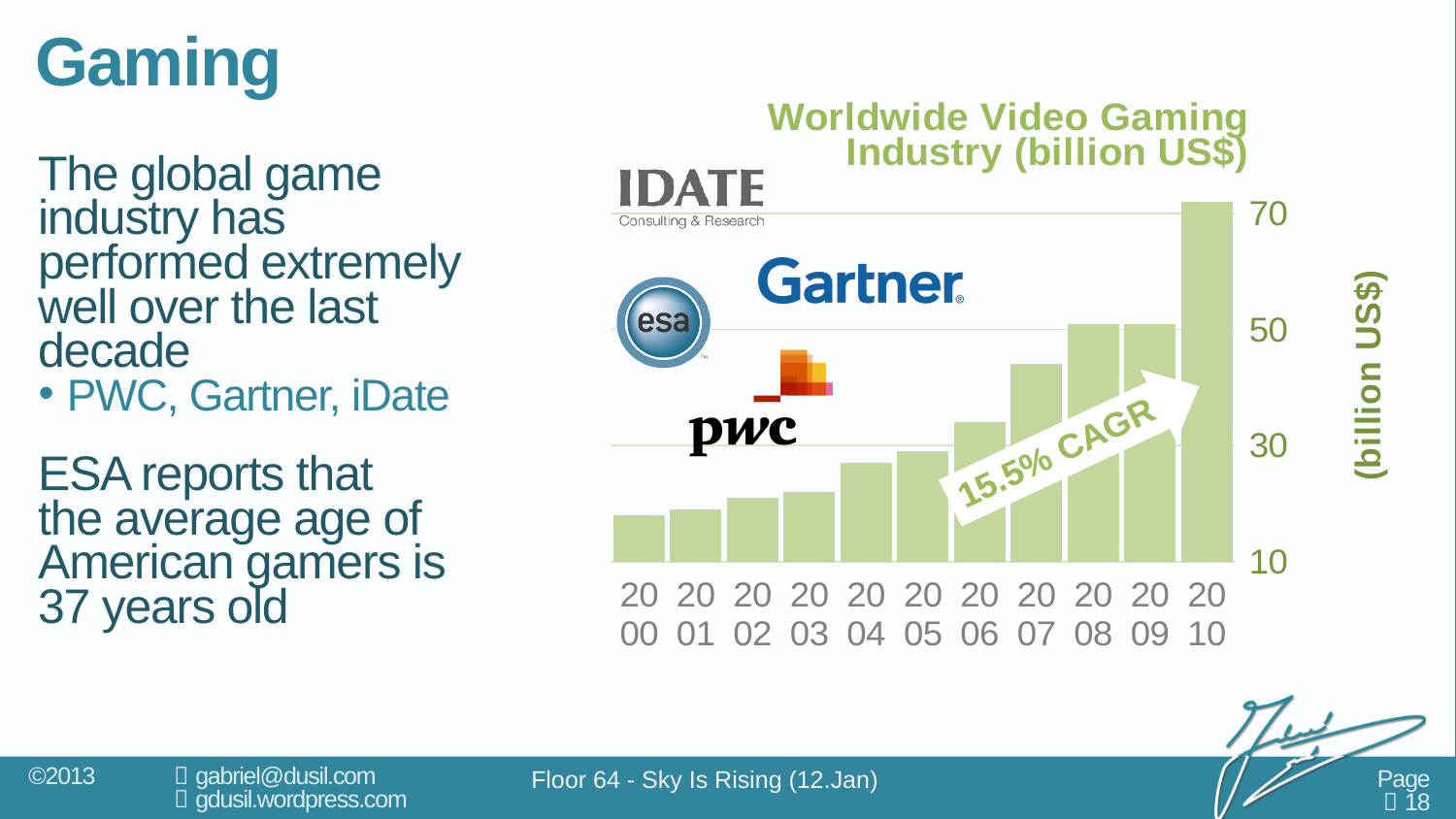
Is the value for 2000 greater or less than 30? less What is the title of the chart? Worldwide Video Gaming Industry (billion US$) What kind of chart is shown on the slide? bar chart Is the value for 2009 greater or less than 30? greater Is the value for 2003 greater or less than 30? less Which is larger, the value for 2010 or the value for 2000? 2010 How many years are plotted on the x axis of the chart? 11 Do the values rise or fall from 2000 to 2010? rise Which year has the highest value in the chart? 2010 What CAGR is printed on the arrow in the chart? 15.5% CAGR